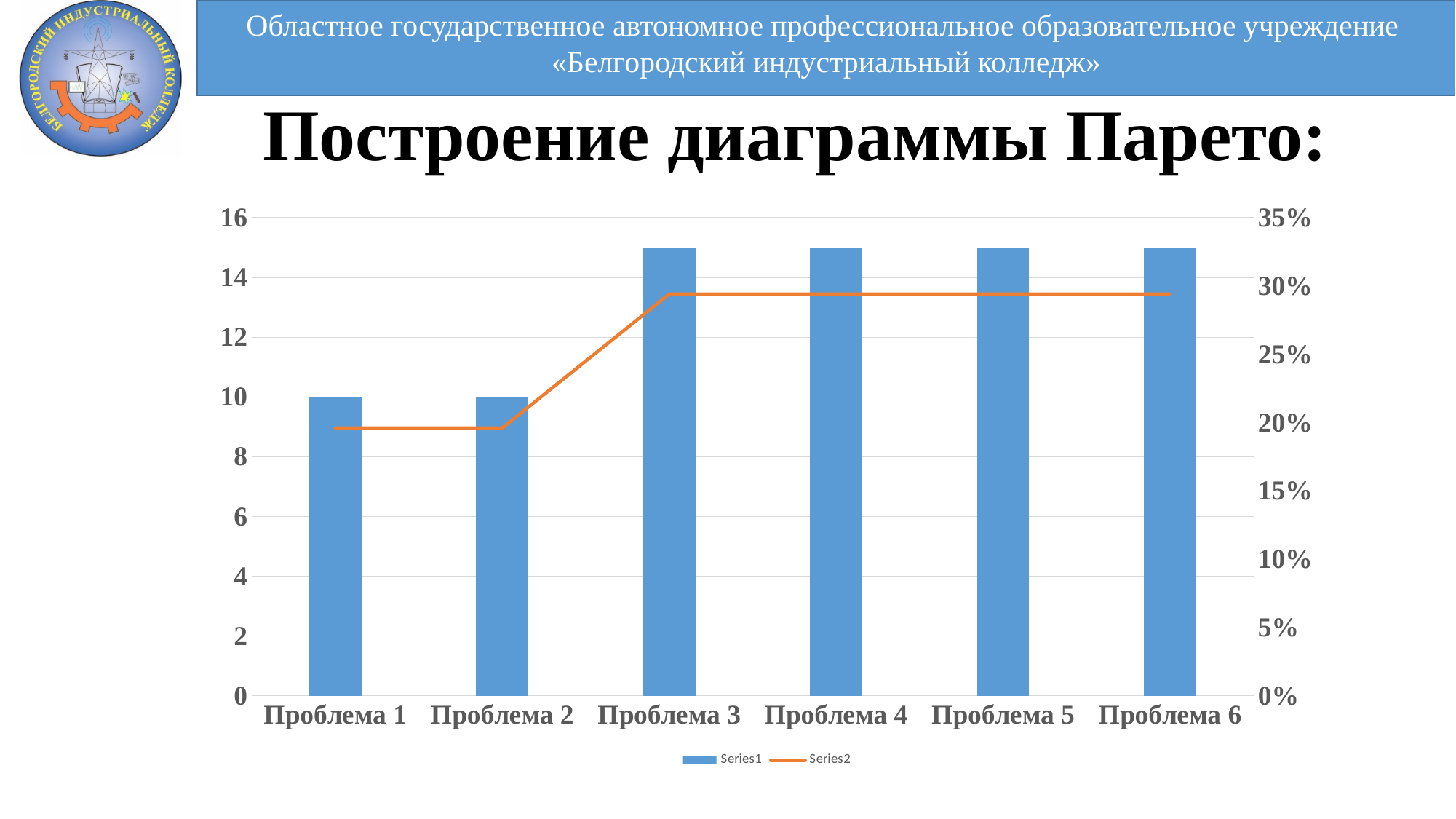
Is the Series1 bar for Проблема 3 greater or less than 14? greater How many categories (problems) are shown on the x axis? 6 What is the value of Series1 for Проблема 1? 10 Is the Series2 line value for Проблема 6 greater or less than 30%? less Which has a taller Series1 bar, Проблема 1 or Проблема 3? Проблема 3 Does the Series2 line rise or fall from Проблема 2 to Проблема 3? rise How many series does the legend list? 2 What kind of chart is shown on the slide? Bar chart with a line series Is the Series1 bar for Проблема 5 greater or less than 16? less What is the value of Series1 for Проблема 2? 10 What is the title of the slide above the chart? Построение диаграммы Парето: